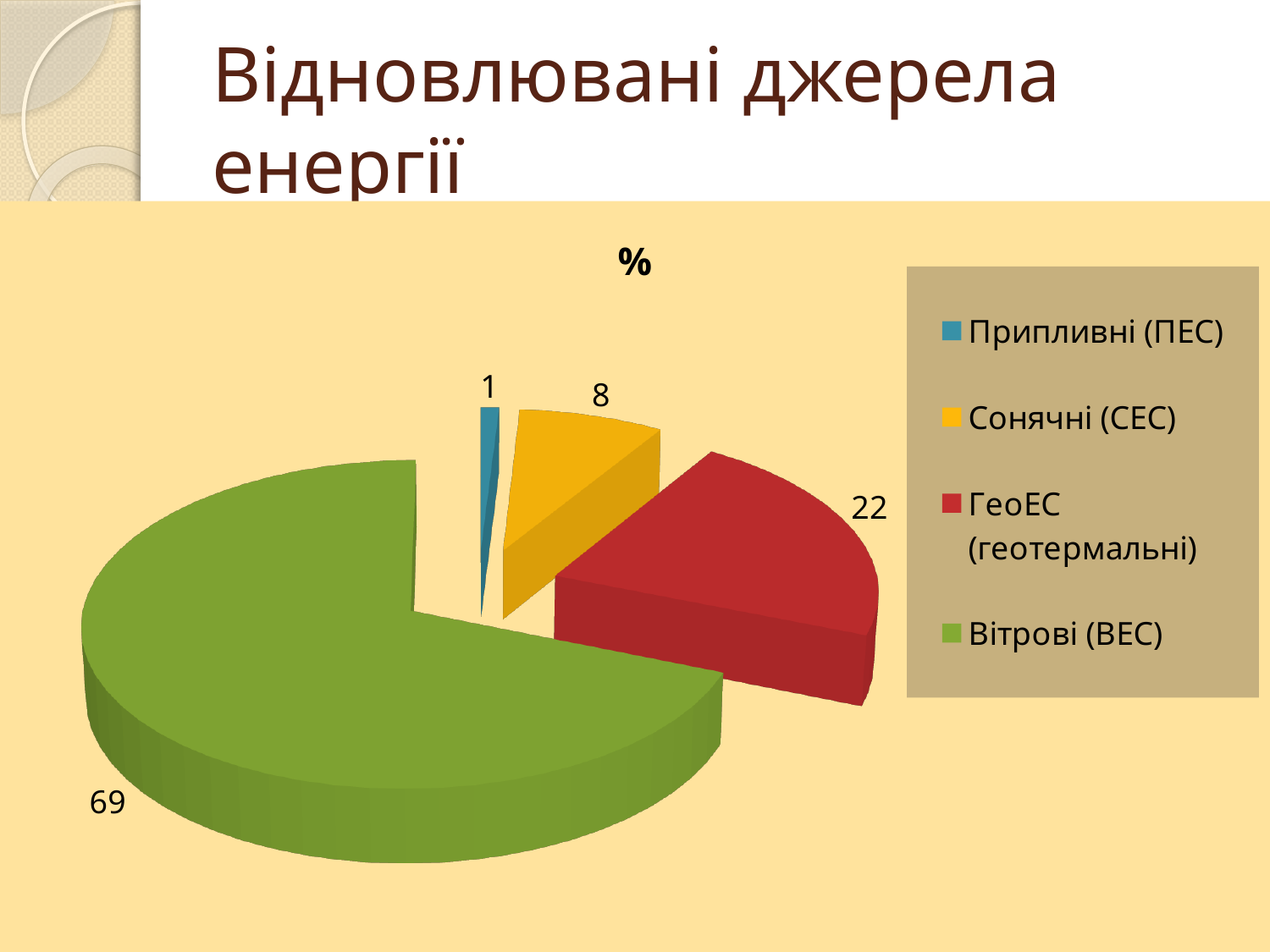
What is the value for Вітрові (ВЕС)? 69 How many slices does the pie chart have? 4 What colour is the slice for ГеоЕС (геотермальні)? red Which category has the largest slice of the pie? Вітрові (ВЕС) What is the difference between the values for Вітрові (ВЕС) and ГеоЕС (геотермальні)? 47 Which category has the smallest slice of the pie? Припливні (ПЕС) What is the title of the chart? % What is the value for ГеоЕС (геотермальні)? 22 What is the value for Припливні (ПЕС)? 1 What kind of chart is shown on the slide? pie chart What is the value for Сонячні (СЕС)? 8 Which is larger, the value for Сонячні (СЕС) or the value for ГеоЕС (геотермальні)? ГеоЕС (геотермальні)